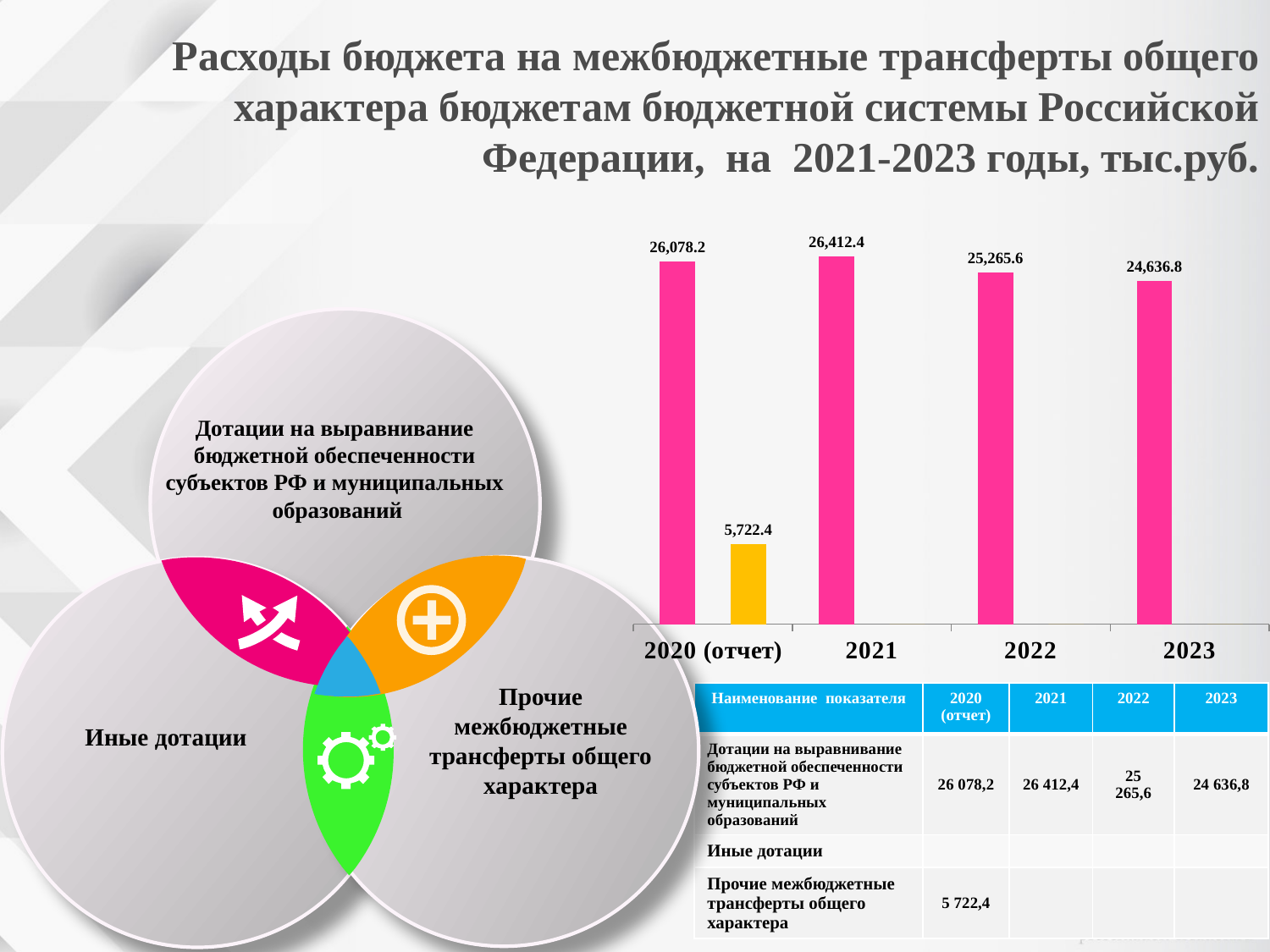
Which year has the highest pink bar? 2021 How many year categories are shown on the x axis of the chart? 4 Which is larger: the pink bar for 2020 (отчет) or the pink bar for 2022? 2020 (отчет) What kind of chart is shown on the slide? bar chart What is the value of the yellow bar for 2020 (отчет)? 5,722.4 Do the pink bar values rise or fall from 2021 to 2023? fall What is the value of the pink bar for 2022? 25,265.6 What is the value of the pink bar for 2023? 24,636.8 Which year has the lowest pink bar? 2023 What is the difference between the pink bar values for 2022 and 2023? 628.8 What is the difference between the pink bar values for 2021 and 2023? 1,775.6 What is the value of the pink bar for 2021? 26,412.4